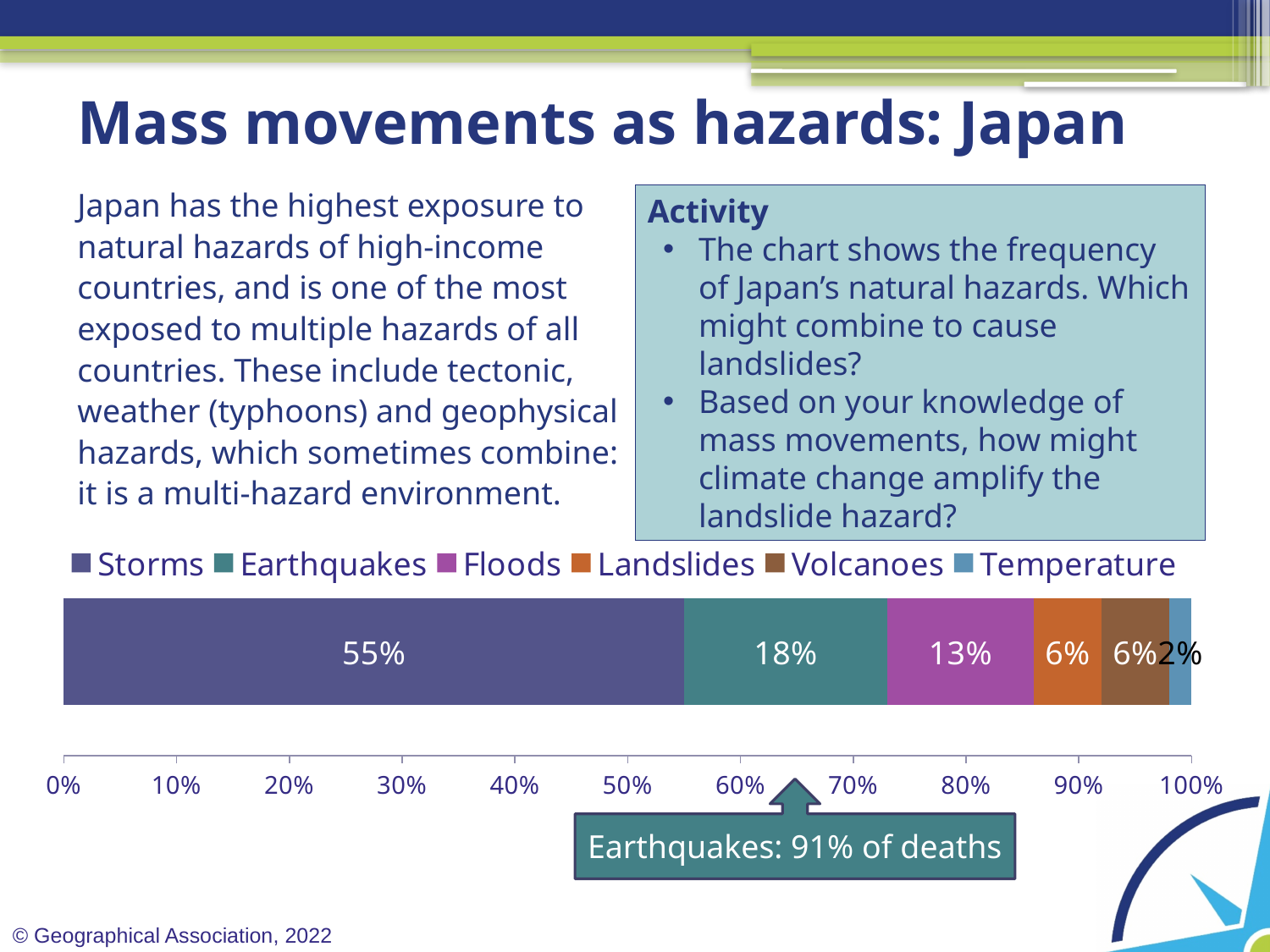
How many series does the legend list? 6 What percentage of Japan's natural hazards are storms according to the chart? 55% According to the callout below the chart, what percentage of deaths are caused by earthquakes? 91% What is the combined share of landslides and volcanoes? 12% Which is larger, the share for floods or the share for landslides? Floods Which hazard has the largest share in the chart? Storms What is the difference between the storms share and the earthquakes share? 37% What percentage does the chart show for floods? 13% What kind of chart is shown on the slide? Stacked bar chart What percentage does the chart show for temperature? 2% What percentage does the chart show for earthquakes? 18% Which hazard has the smallest share in the chart? Temperature